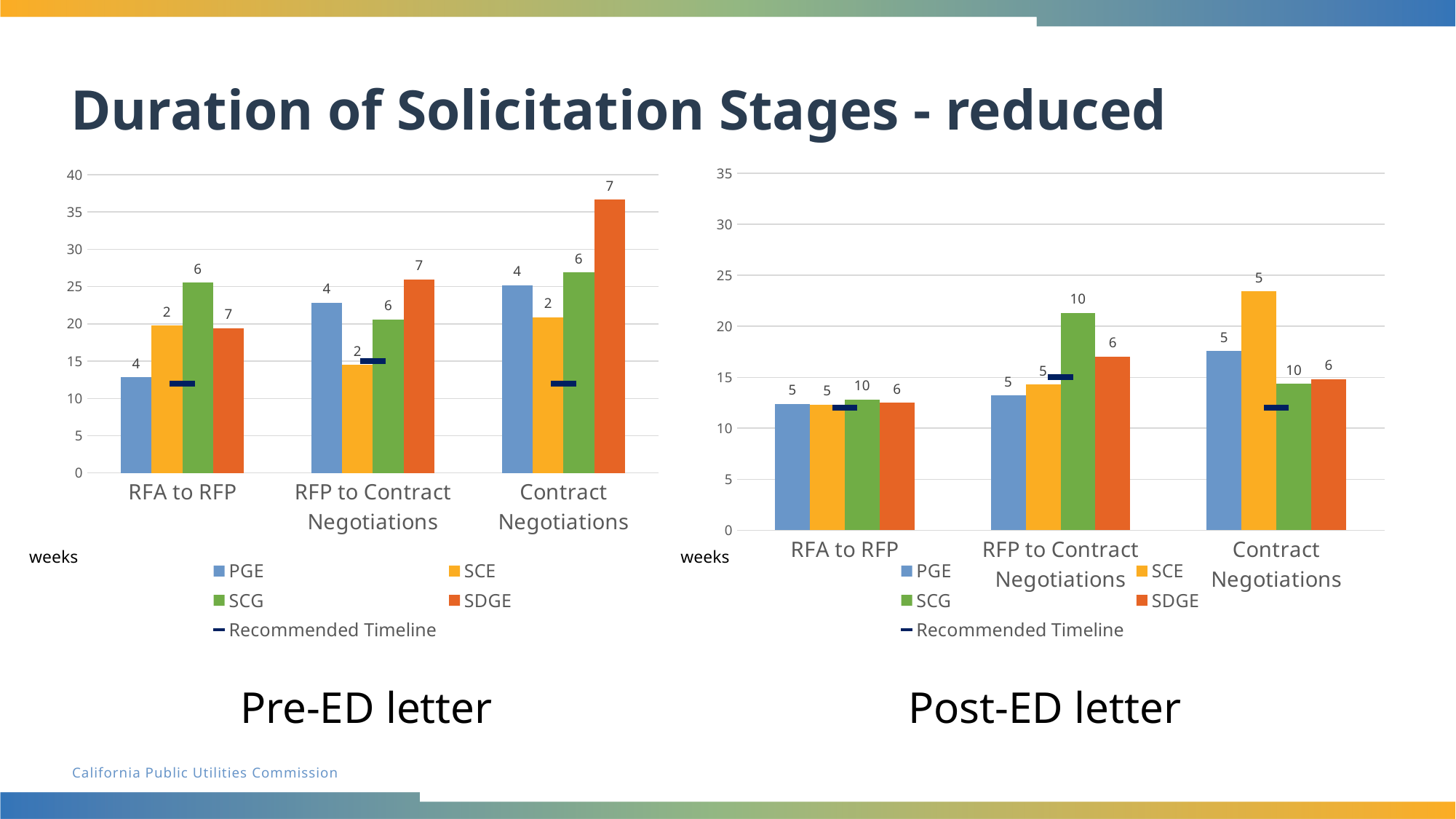
In the Post-ED letter chart, which utility has the tallest bar in the RFP to Contract Negotiations stage? SCG How many solicitation stage categories are shown on the x axis of the Pre-ED letter chart? 3 What unit is labelled on the vertical axis of both charts? weeks In the Post-ED letter chart, is the PGE bar for RFP to Contract Negotiations greater or less than 15? less In the Post-ED letter chart, for Contract Negotiations, which bar is taller: PGE or SCG? PGE In the Pre-ED letter chart, for RFP to Contract Negotiations, which bar is taller: PGE or SCE? PGE In the Post-ED letter chart, is the SCE bar for Contract Negotiations greater or less than 20? greater In the Pre-ED letter chart, which utility has the shortest bar in the RFA to RFP stage? PGE How many entries does the legend of the Post-ED letter chart list? 5 In the Pre-ED letter chart, which utility has the tallest bar in the Contract Negotiations stage? SDGE In the Pre-ED letter chart, is the SDGE bar for Contract Negotiations greater or less than 35? greater What kind of chart is the Pre-ED letter chart? bar chart